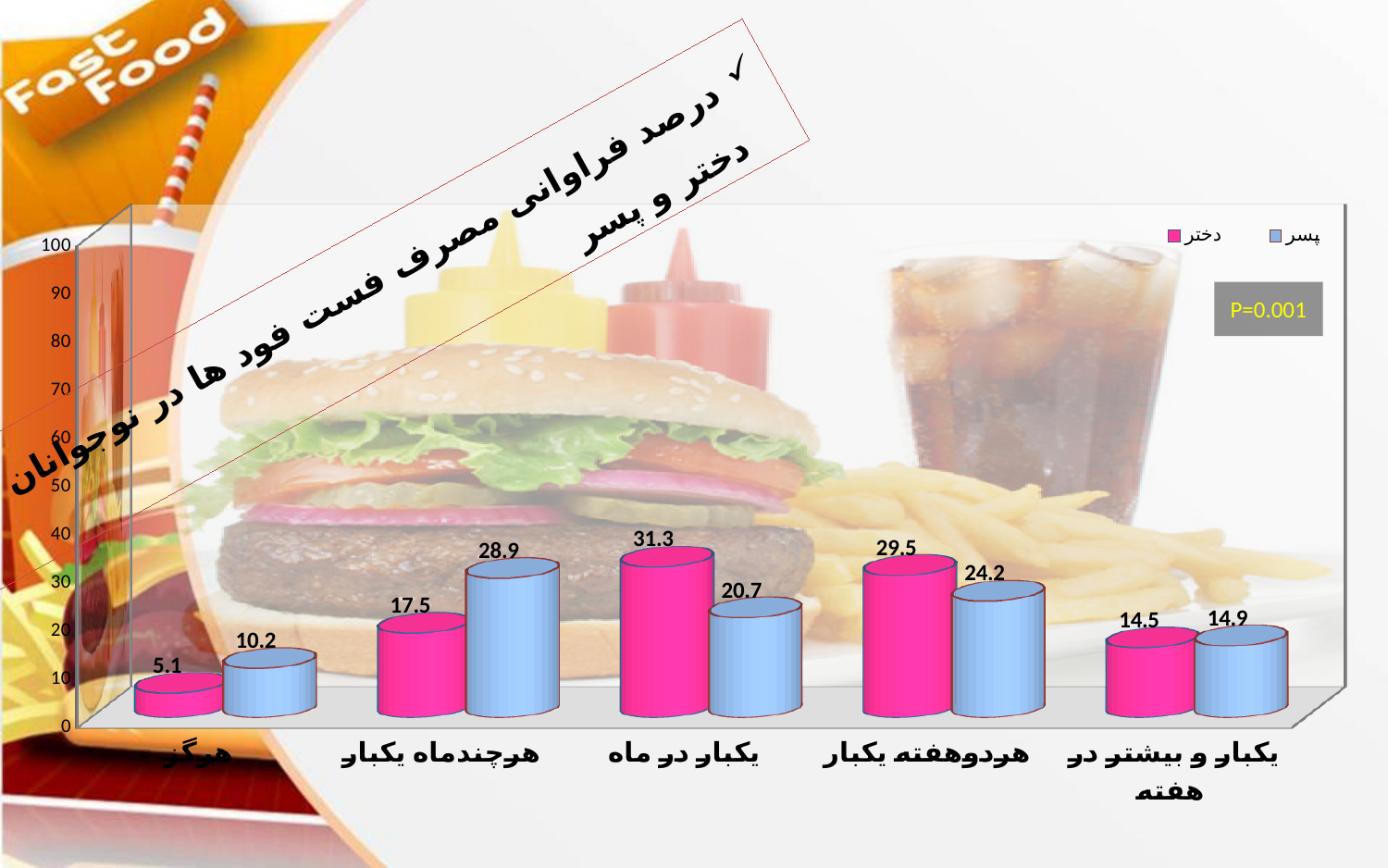
What is the value for پسر in the یکبار و بیشتر در هفته category? 14.9 What is the difference between the پسر and دختر values in the هرچندماه یکبار category? 11.4 Which category has the lowest value for the پسر series? هرگز How many series does the legend list? 2 What is the value for پسر in the هرچندماه یکبار category? 28.9 What kind of chart is shown on the slide? bar chart In the هردوهفته یکبار category, which series has the larger value, دختر or پسر? دختر What is the value for دختر in the یکبار در ماه category? 31.3 What is the value for دختر in the هرگز category? 5.1 Which category has the highest value for the دختر series? یکبار در ماه How many categories are shown on the x axis? 5 What P value is shown on the chart? P=0.001